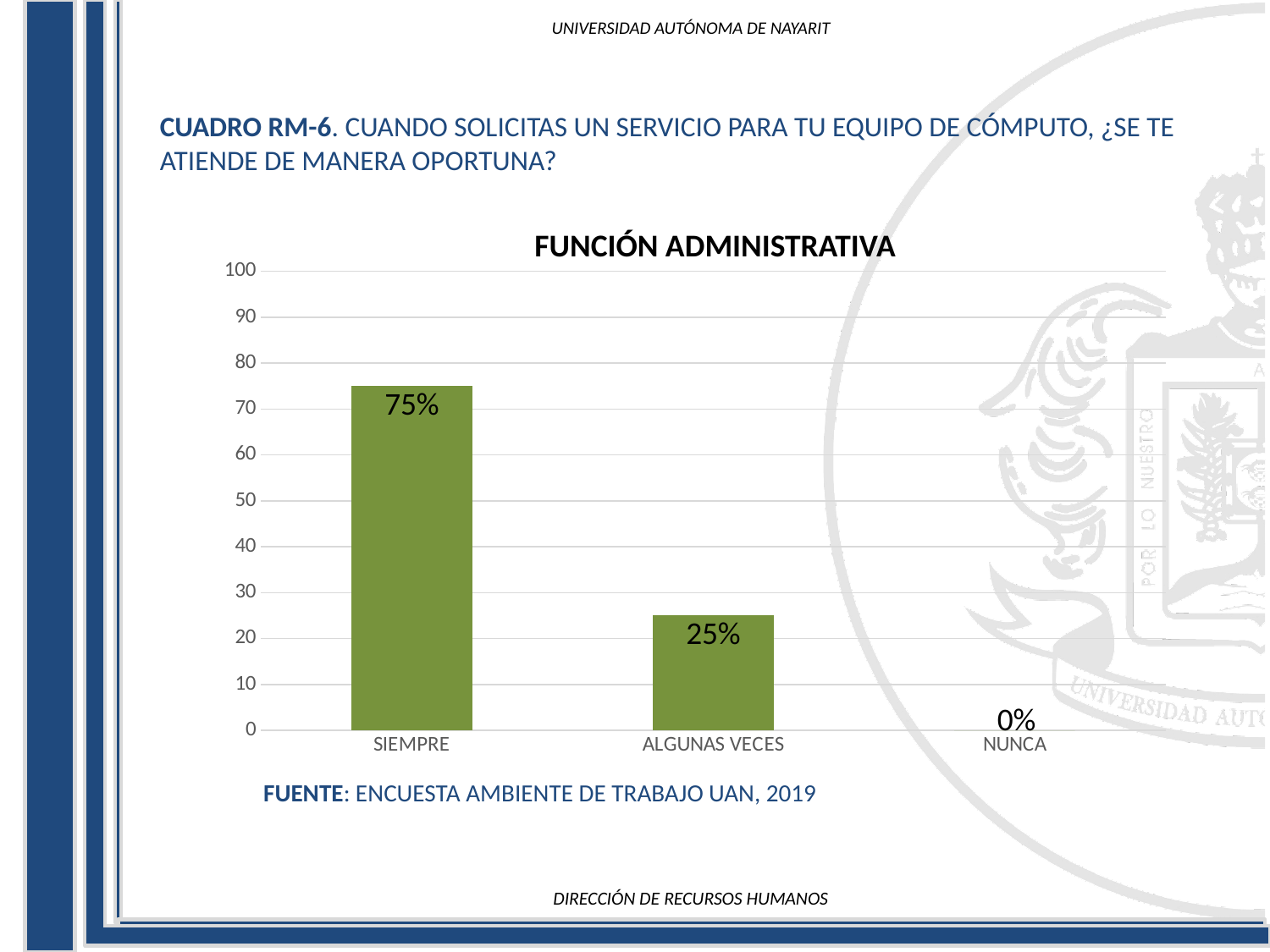
How many categories are shown on the x axis? 3 What is the value for ALGUNAS VECES? 25% Is the value for ALGUNAS VECES greater or less than 30? less What is the title of the chart? FUNCIÓN ADMINISTRATIVA Is the value for SIEMPRE greater or less than 60? greater Which is larger, the value for SIEMPRE or the value for ALGUNAS VECES? SIEMPRE What kind of chart is shown on the slide? bar chart What is the value for SIEMPRE? 75% Which category has the lowest value? NUNCA What is the value for NUNCA? 0% What is the difference between the values for SIEMPRE and ALGUNAS VECES? 50% Which category has the highest value? SIEMPRE